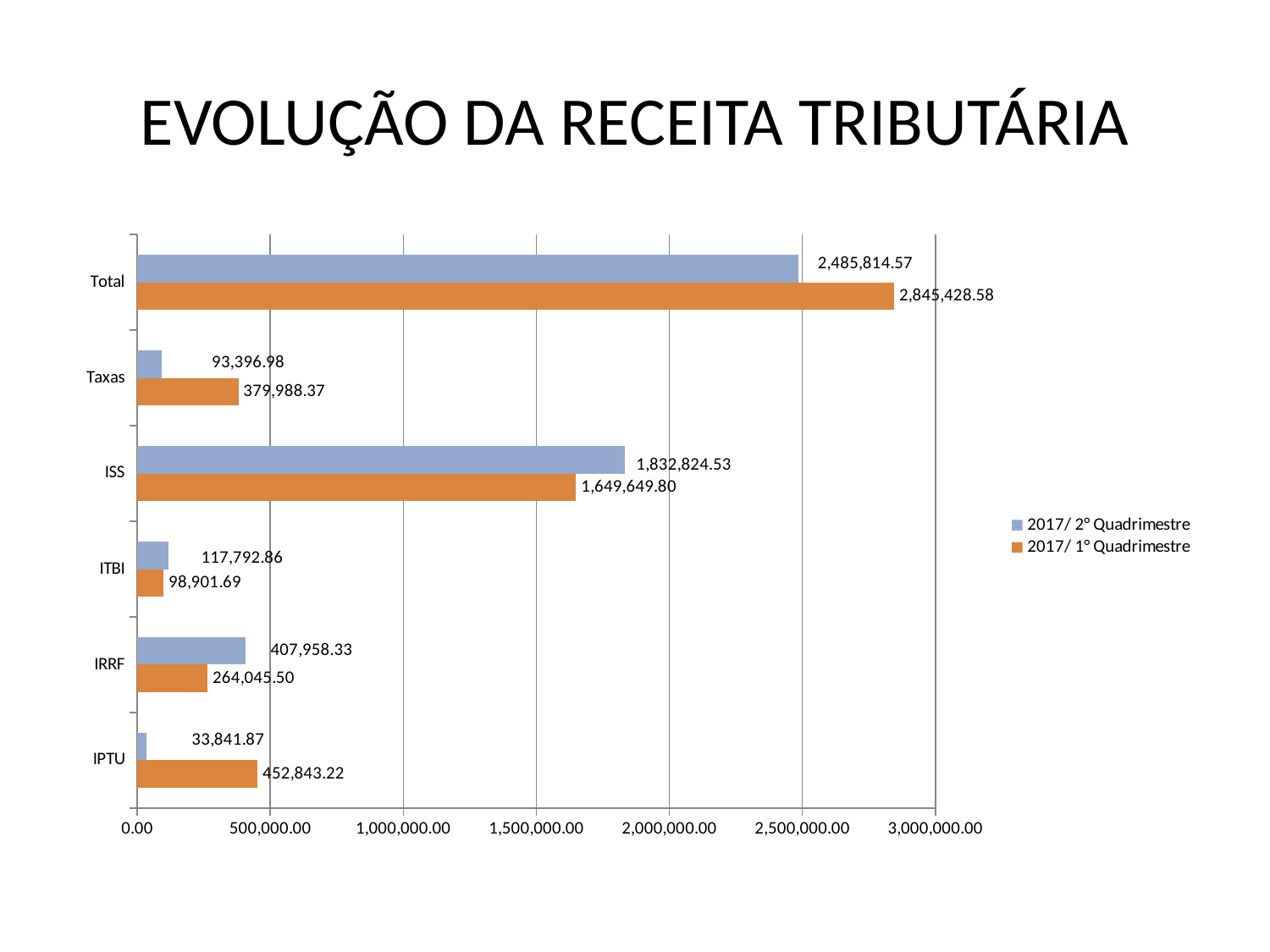
What kind of chart is shown on the slide? Bar chart For IRRF, which series has the larger value, 2017/ 2° Quadrimestre or 2017/ 1° Quadrimestre? 2017/ 2° Quadrimestre What is the difference between the 2017/ 2° Quadrimestre and 2017/ 1° Quadrimestre values for ISS? 183,174.73 What is the Total value for the 2017/ 2° Quadrimestre series? 2,485,814.57 What is the value for IPTU in the 2017/ 1° Quadrimestre series? 452,843.22 What is the value for ISS in the 2017/ 2° Quadrimestre series? 1,832,824.53 How many series does the legend list? 2 How many categories are shown on the chart? 6 Which category has the lowest value in the 2017/ 2° Quadrimestre series? IPTU What is the difference between the 2017/ 1° Quadrimestre and 2017/ 2° Quadrimestre values for IPTU? 419,001.35 What is the value for Taxas in the 2017/ 1° Quadrimestre series? 379,988.37 Excluding Total, which category has the highest value in the 2017/ 1° Quadrimestre series? ISS